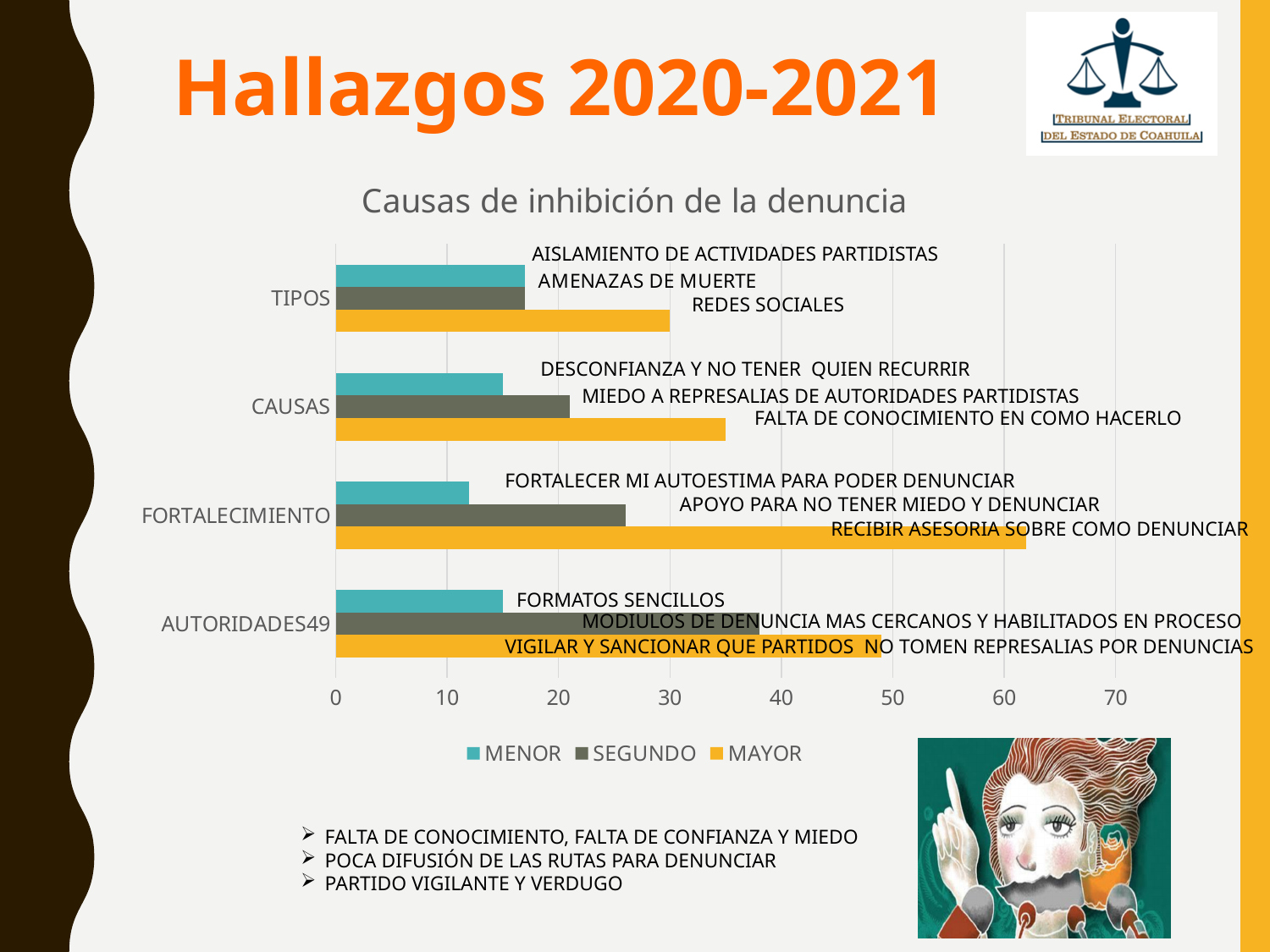
What kind of chart is shown on the slide? bar chart Which category has the highest MAYOR value? FORTALECIMIENTO Which series are listed in the legend? MENOR, SEGUNDO, MAYOR Which is larger for AUTORIDADES, the MENOR value or the SEGUNDO value? SEGUNDO Is the MAYOR value for CAUSAS greater or less than 30? greater What is the title of the chart? Causas de inhibición de la denuncia Which is larger, the MAYOR value for FORTALECIMIENTO or the MAYOR value for AUTORIDADES? FORTALECIMIENTO How many series does the legend list? 3 Is the MENOR value for FORTALECIMIENTO greater or less than 20? less How many categories are shown on the vertical axis of the chart? 4 Is the SEGUNDO value for AUTORIDADES greater or less than 30? greater